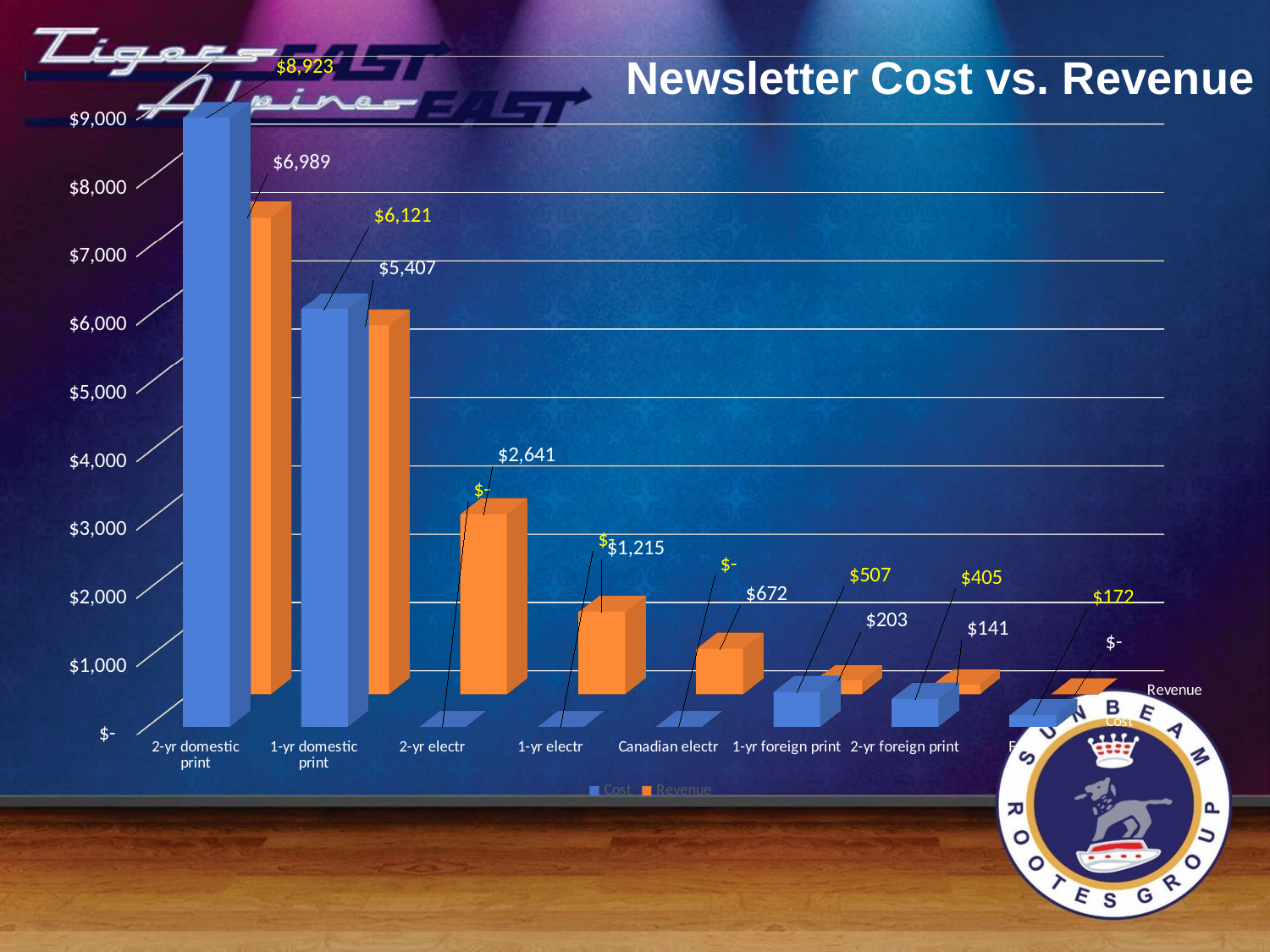
What is the Revenue value for 1-yr domestic print? $5,407 Which category has the highest Revenue? 2-yr domestic print What is the Revenue value for Canadian electr? $672 For 1-yr domestic print, which is larger, Cost or Revenue? Cost What is the Revenue value for 2-yr electr? $2,641 What is the difference between Cost and Revenue for 2-yr domestic print? $1,934 Is the Revenue value for 1-yr electr greater or less than $2,000? less What is the title of the chart? Newsletter Cost vs. Revenue What kind of chart is shown on the slide? bar chart What is the Cost value for 2-yr domestic print? $8,923 How many series does the legend list? 2 What is the Cost value for 1-yr foreign print? $507